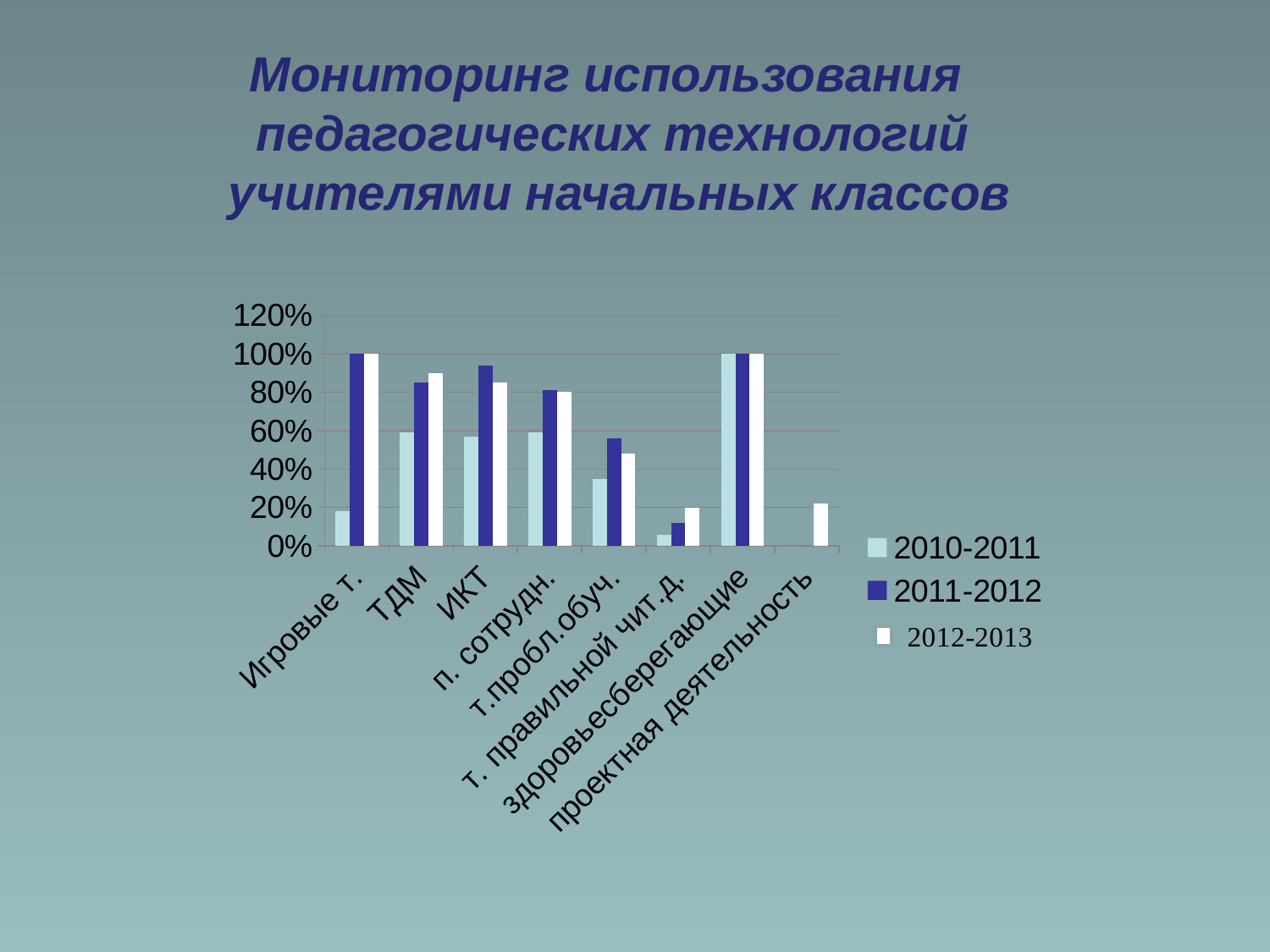
What kind of chart is shown on the slide? bar chart For ИКТ, which series has the larger value: 2010-2011 or 2011-2012? 2011-2012 What is the value for здоровьесберегающие in the 2011-2012 series? 100% Is the value for п. сотрудн. in the 2011-2012 series greater or less than 60%? greater Which category has the highest value in the 2010-2011 series? здоровьесберегающие How many series does the chart's legend list? 3 How many categories are shown on the x axis of the chart? 8 Is the value for ТДМ in the 2010-2011 series greater or less than 40%? greater What is the value for Игровые т. in the 2012-2013 series? 100% Is the value for т. правильной чит.д. in the 2012-2013 series greater or less than 40%? less For т. правильной чит.д., do the values rise or fall from 2010-2011 to 2012-2013? rise What are the three entries listed in the chart's legend? 2010-2011, 2011-2012, 2012-2013